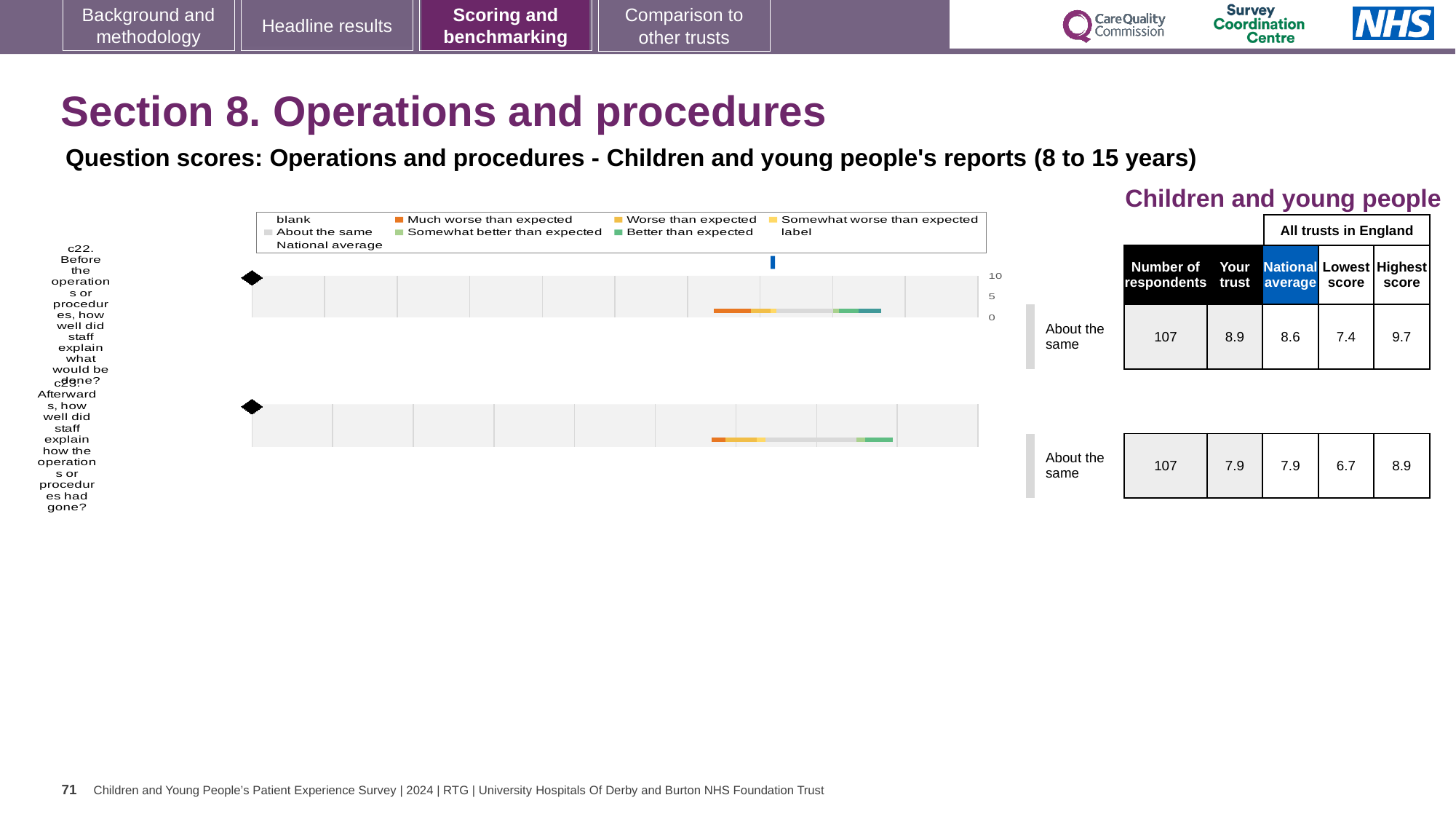
What is the difference between the highest score and the lowest score for question c22? 2.3 What is the highest score among all trusts in England for question c23? 8.9 What benchmarking category is shown next to the bar for question c23? About the same What is the lowest score among all trusts in England for question c22? 7.4 How many survey questions are plotted in the chart? 2 For question c22, which is larger: the 'Your trust' score or the national average? Your trust What is the national average score for question c22? 8.6 What is the 'Your trust' score for question c23 (Afterwards, how well did staff explain how the operations or procedures had gone?)? 7.9 What is the 'Your trust' score for question c22 (Before the operations or procedures, how well did staff explain what would be done?)? 8.9 What is the highest score among all trusts in England for question c22? 9.7 How many respondents answered question c22? 107 What kind of chart is shown on the slide? bar chart